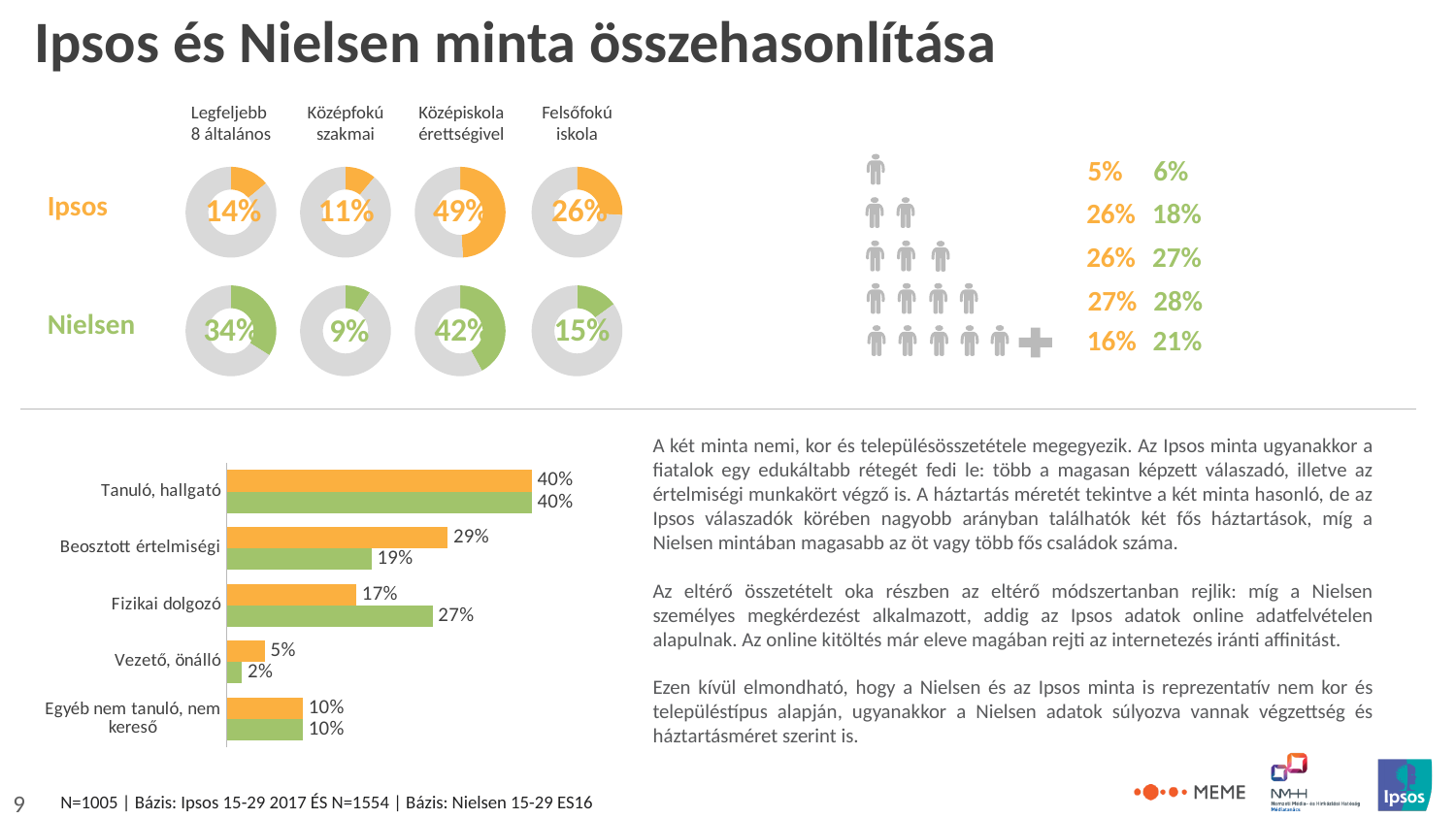
In the top-left donut charts, what is the Nielsen value for Legfeljebb 8 általános? 34% In the top-left donut charts, what is the difference between the Ipsos and Nielsen values for Felsőfokú iskola? 11% In the bottom-left bar chart, what is the orange (Ipsos) value for Beosztott értelmiségi? 29% In the bottom-left bar chart, which category has the lowest green (Nielsen) value? Vezető, önálló How many categories are shown in the bottom-left bar chart? 5 In the bottom-left bar chart, which category has the highest value for both series? Tanuló, hallgató In the top-left donut charts, what is the Ipsos value for Középiskola érettségivel? 49% In the bottom-left bar chart, what is the difference between the orange and green values for Beosztott értelmiségi? 10% What type of chart is shown in the bottom-left of the slide? bar chart In the bottom-left bar chart, for Fizikai dolgozó, which is larger: the orange (Ipsos) bar or the green (Nielsen) bar? green (Nielsen) In the bottom-left bar chart, what is the green (Nielsen) value for Fizikai dolgozó? 27% In the top-right household size chart, what is the green (Nielsen) value for the five-or-more-person household row? 21%